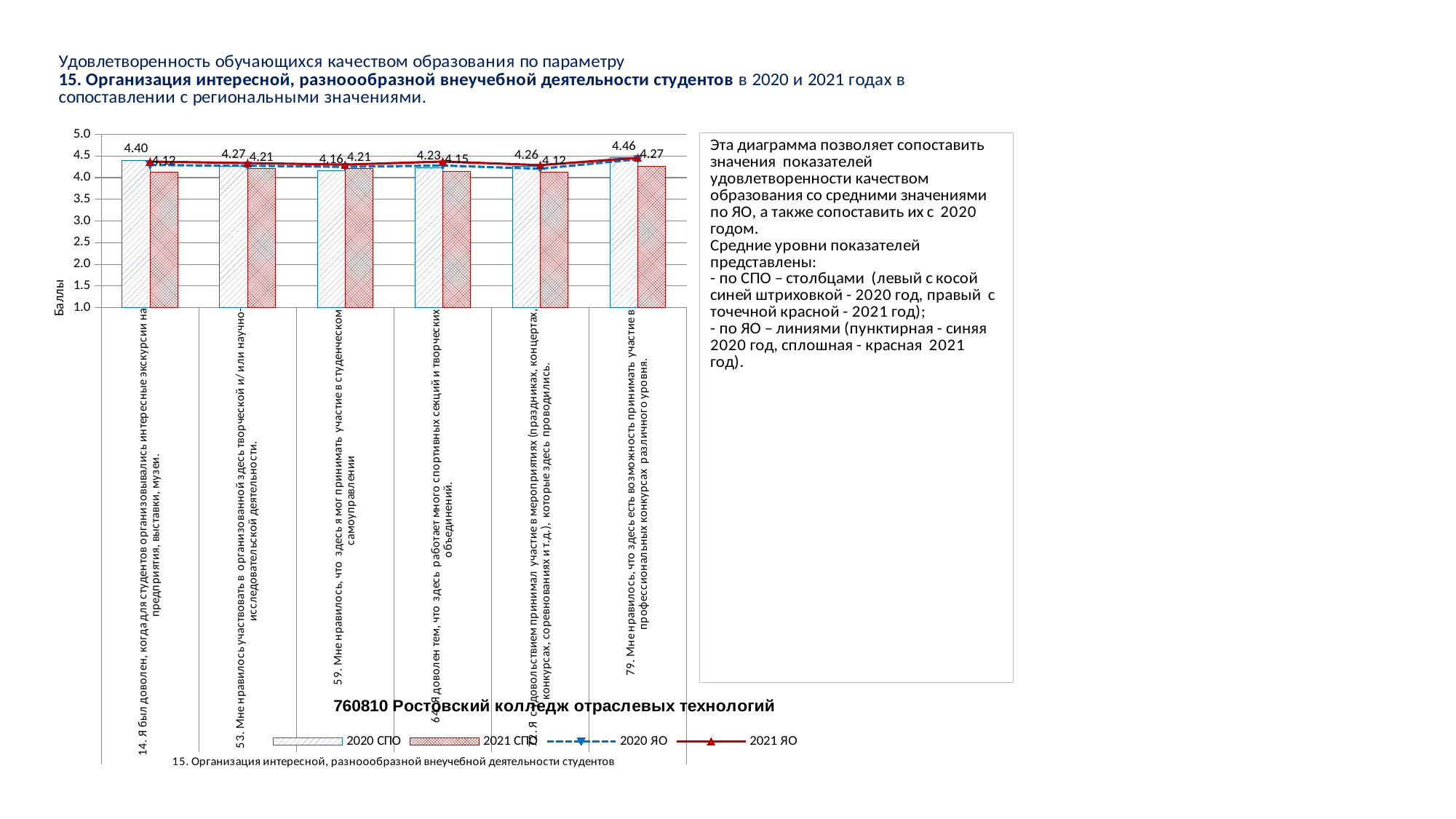
What is the 2021 СПО value for item 53 (creative and/or research activity)? 4.21 For item 59 (student self-government), which is larger: the 2020 СПО value or the 2021 СПО value? 2021 СПО How many series does the chart legend list? 4 What kind of chart is shown on the slide? A combined bar and line chart What is the 2020 СПО value for item 14 (excursions to enterprises, exhibitions, museums)? 4.40 What is the difference between the 2020 СПО and 2021 СПО values for item 14? 0.28 Which item has the highest 2020 СПО value? 79. Мне нравилось, что здесь есть возможность принимать участие в профессиональных конкурсах различного уровня. What is the title of the vertical axis of the chart? Баллы What is the 2021 СПО value for item 79 (participation in professional competitions of various levels)? 4.27 How many items (categories) are shown on the x axis of the chart? 6 Which item has the lowest 2020 СПО value? 59. Мне нравилось, что здесь я мог принимать участие в студенческом самоуправлении